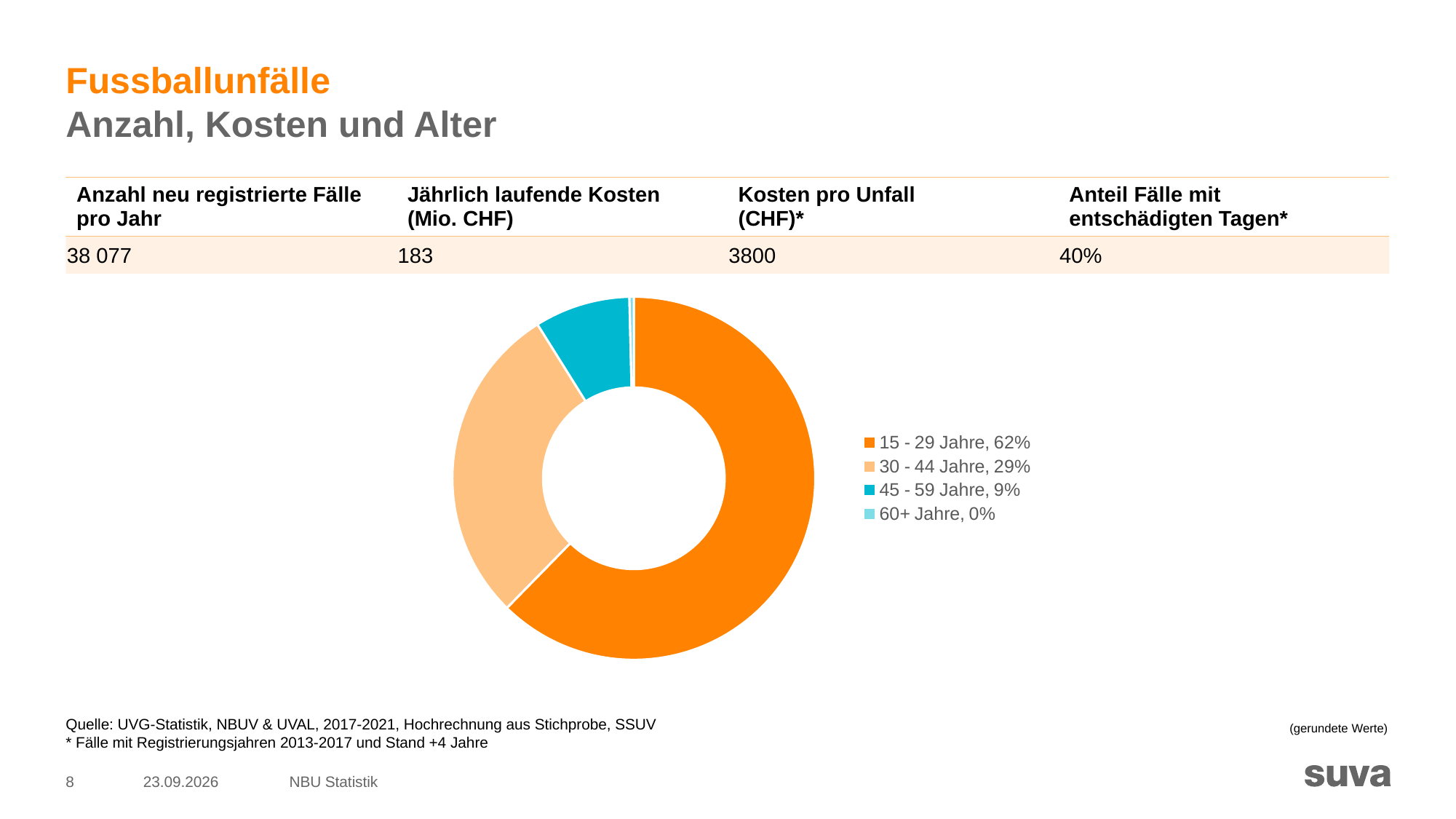
How many age categories does the chart's legend list? 4 What share of football accidents falls in the 45 - 59 Jahre age group? 9% What share of football accidents falls in the 30 - 44 Jahre age group? 29% Which age group has the smallest share in the chart? 60+ Jahre By how many percentage points does the share of 15 - 29 Jahre exceed that of 30 - 44 Jahre? 33 percentage points Which age group has the largest share in the chart? 15 - 29 Jahre What kind of chart is shown on the slide? Pie chart (doughnut) What colour represents the 45 - 59 Jahre age group in the chart? Teal (blue-green) What share is shown for the 60+ Jahre age group? 0% Which has the larger share: 30 - 44 Jahre or 45 - 59 Jahre? 30 - 44 Jahre What is the combined share of the 15 - 29 Jahre and 30 - 44 Jahre age groups? 91% What share of football accidents falls in the 15 - 29 Jahre age group? 62%